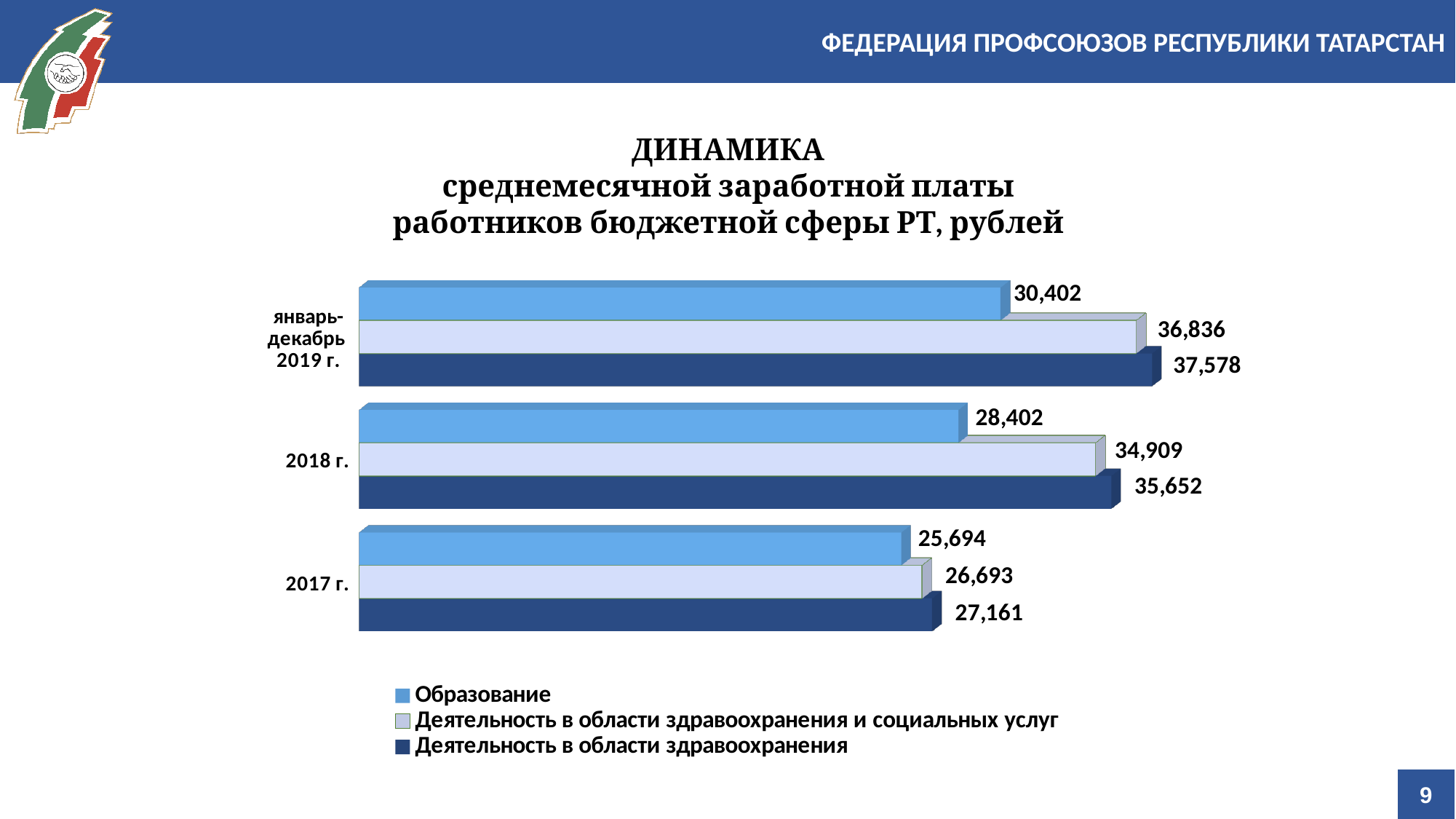
What kind of chart is shown on the slide? Bar chart How many categories (periods) are shown on the chart? 3 Which series has the highest value in 2018 г.? Деятельность в области здравоохранения What is the value for Деятельность в области здравоохранения и социальных услуг in 2018 г.? 34,909 Which series has the lowest value in январь-декабрь 2019 г.? Образование What is the value for Деятельность в области здравоохранения in январь-декабрь 2019 г.? 37,578 What is the value for Образование in 2017 г.? 25,694 Which legend entry is shown in the darkest blue colour? Деятельность в области здравоохранения Which is larger: Деятельность в области здравоохранения in 2017 г. or Образование in 2018 г.? Образование in 2018 г. What is the difference between the Образование values for январь-декабрь 2019 г. and 2017 г.? 4,708 How many series does the legend list? 3 Do the Образование values rise or fall from 2017 г. to январь-декабрь 2019 г.? Rise